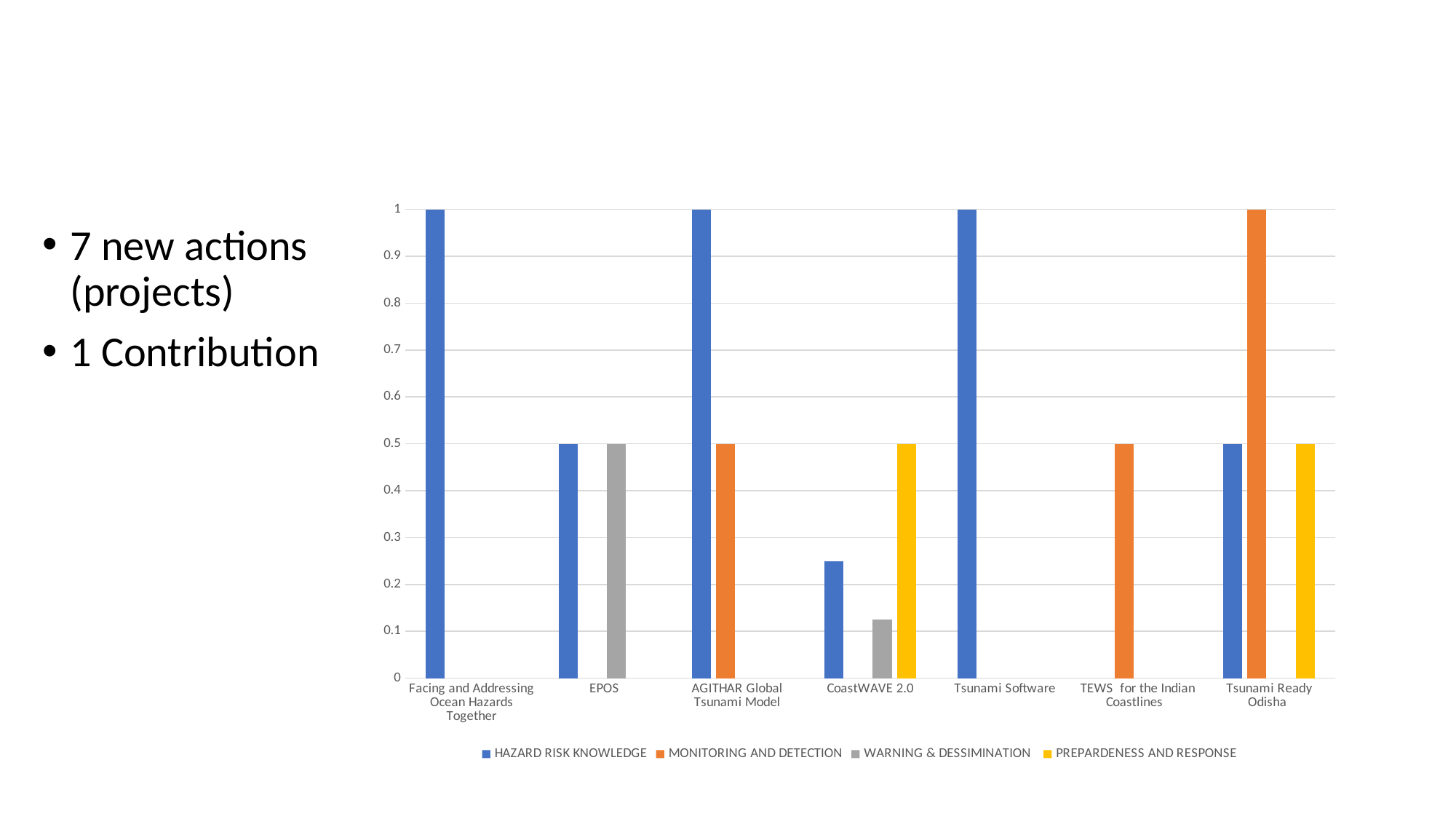
What is the MONITORING AND DETECTION value for Tsunami Ready Odisha? 1 What is the WARNING & DESSIMINATION value for EPOS? 0.5 How many categories are shown on the x axis? 7 What is the HAZARD RISK KNOWLEDGE value for Tsunami Software? 1 What is the HAZARD RISK KNOWLEDGE value for EPOS? 0.5 What is the difference between the HAZARD RISK KNOWLEDGE value for Tsunami Software and for Tsunami Ready Odisha? 0.5 How many series does the legend list? 4 Which series is shown in orange in the legend? MONITORING AND DETECTION What kind of chart is shown on the slide? bar chart Is the HAZARD RISK KNOWLEDGE value for CoastWAVE 2.0 greater or less than 0.5? less Which is larger: the HAZARD RISK KNOWLEDGE value for AGITHAR Global Tsunami Model or for EPOS? AGITHAR Global Tsunami Model Is the WARNING & DESSIMINATION value for CoastWAVE 2.0 greater or less than 0.2? less